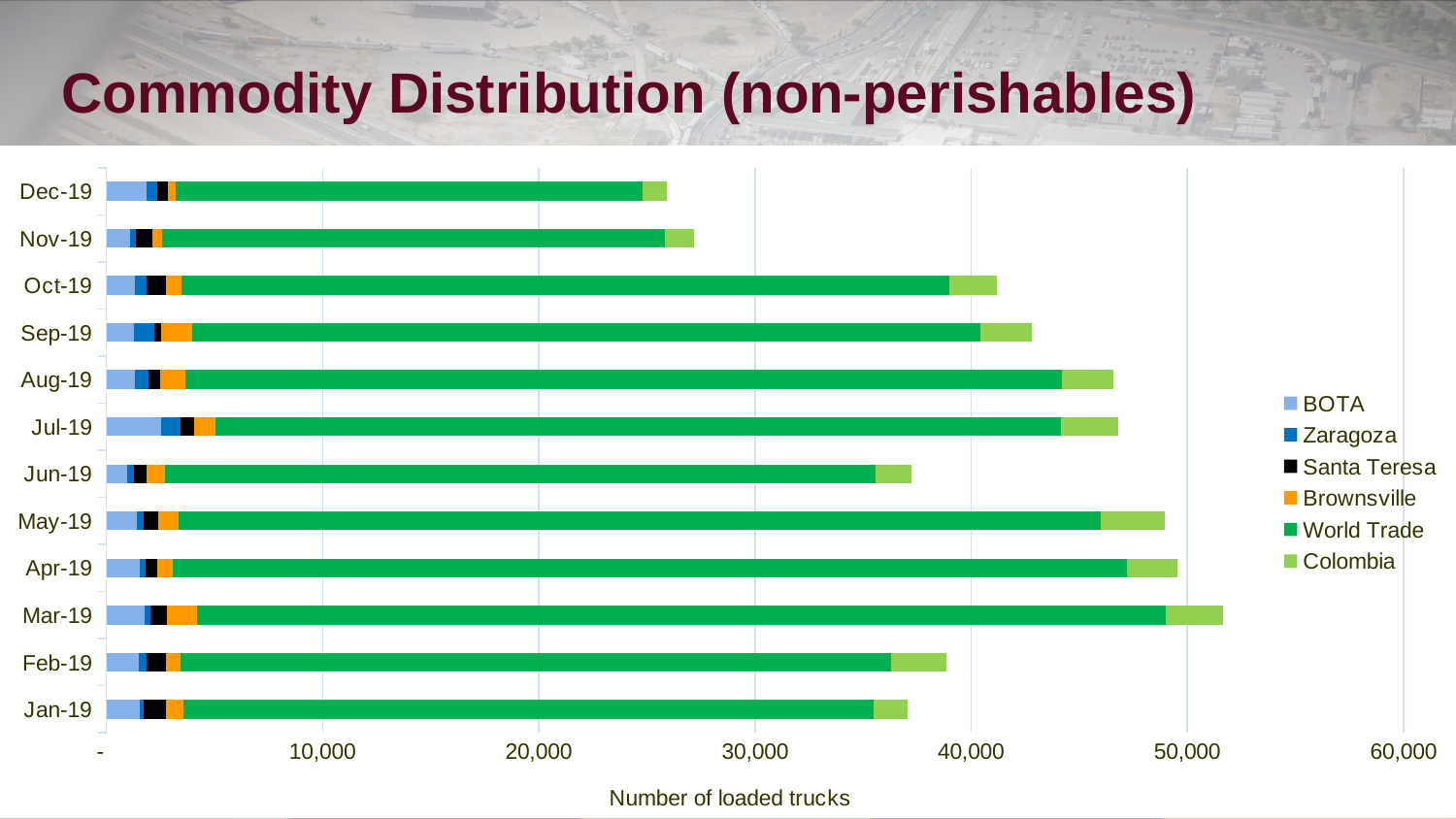
Which month has the highest total number of loaded trucks? Mar-19 Is the total number of loaded trucks for Jun-19 greater or less than 40,000? less Is the total number of loaded trucks for Dec-19 greater or less than 30,000? less Which month has a larger total number of loaded trucks, Apr-19 or Feb-19? Apr-19 Is the total number of loaded trucks for Apr-19 greater or less than 40,000? greater What is the title of the horizontal axis? Number of loaded trucks How many series does the legend list? 6 What kind of chart is shown on the slide? Stacked bar chart Which month has a larger total number of loaded trucks, Oct-19 or Nov-19? Oct-19 Which series makes up the largest segment of every bar? World Trade Do the total numbers of loaded trucks rise or fall from Aug-19 to Dec-19? fall How many months are plotted on the chart? 12